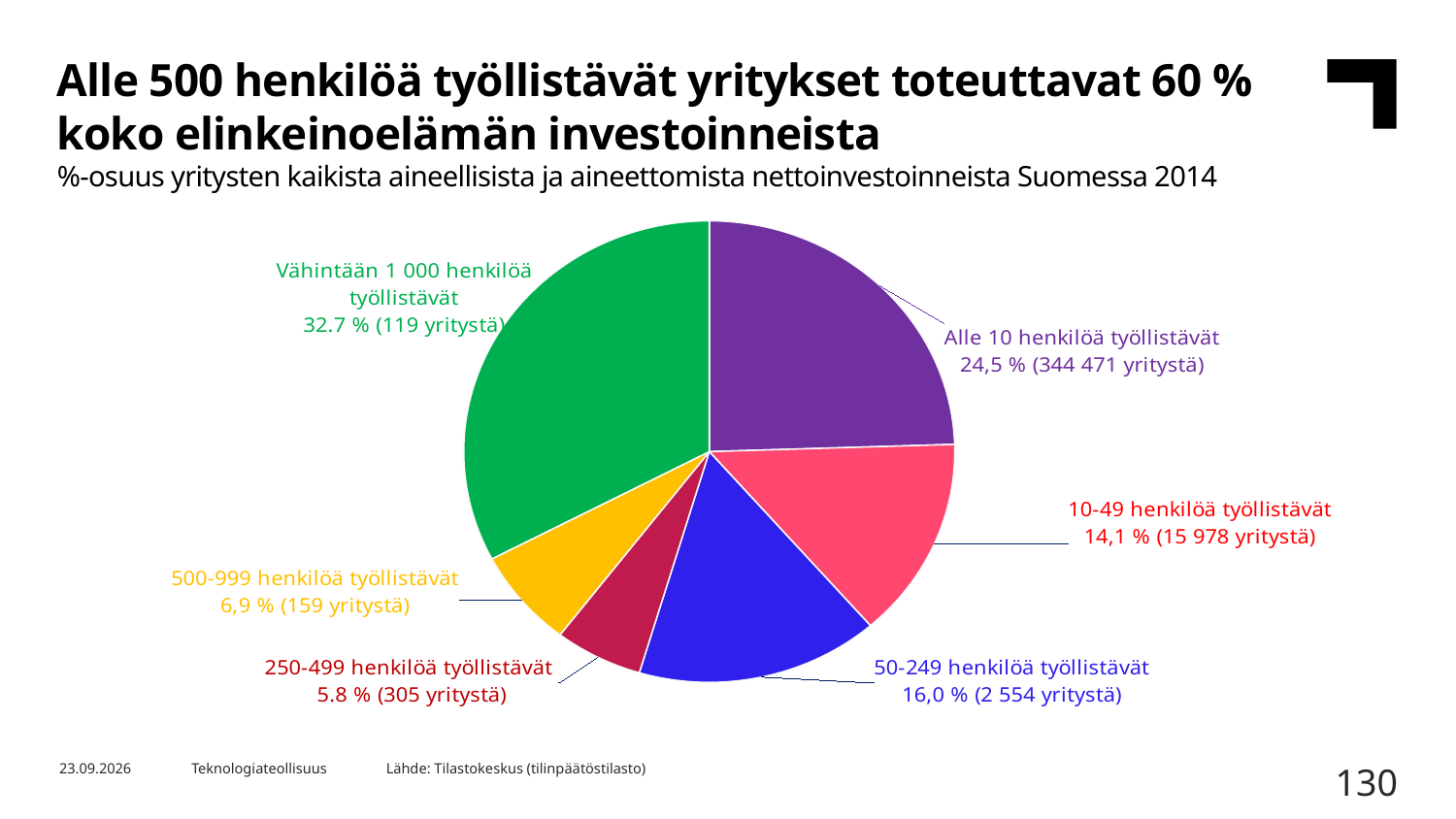
What share of net investments is attributed to companies employing at least 1 000 people (Vähintään 1 000 henkilöä työllistävät)? 32.7 % What share of net investments is attributed to companies employing fewer than 10 people (Alle 10 henkilöä työllistävät)? 24,5 % Which category has the smallest share of the pie? 250-499 henkilöä työllistävät Which has a larger share: 10-49 henkilöä työllistävät or 50-249 henkilöä työllistävät? 50-249 henkilöä työllistävät Which category has the largest share of the pie? Vähintään 1 000 henkilöä työllistävät How many companies are in the 500-999 henkilöä työllistävät category? 159 What colour is the slice for 500-999 henkilöä työllistävät? Yellow What kind of chart is shown on the slide? Pie chart What percentage is shown for companies employing 50-249 people? 16,0 % How many slices does the pie chart have? 6 What is the difference in percentage points between the share of Vähintään 1 000 henkilöä työllistävät and Alle 10 henkilöä työllistävät? 8.2 percentage points How many companies are in the 10-49 henkilöä työllistävät category? 15 978